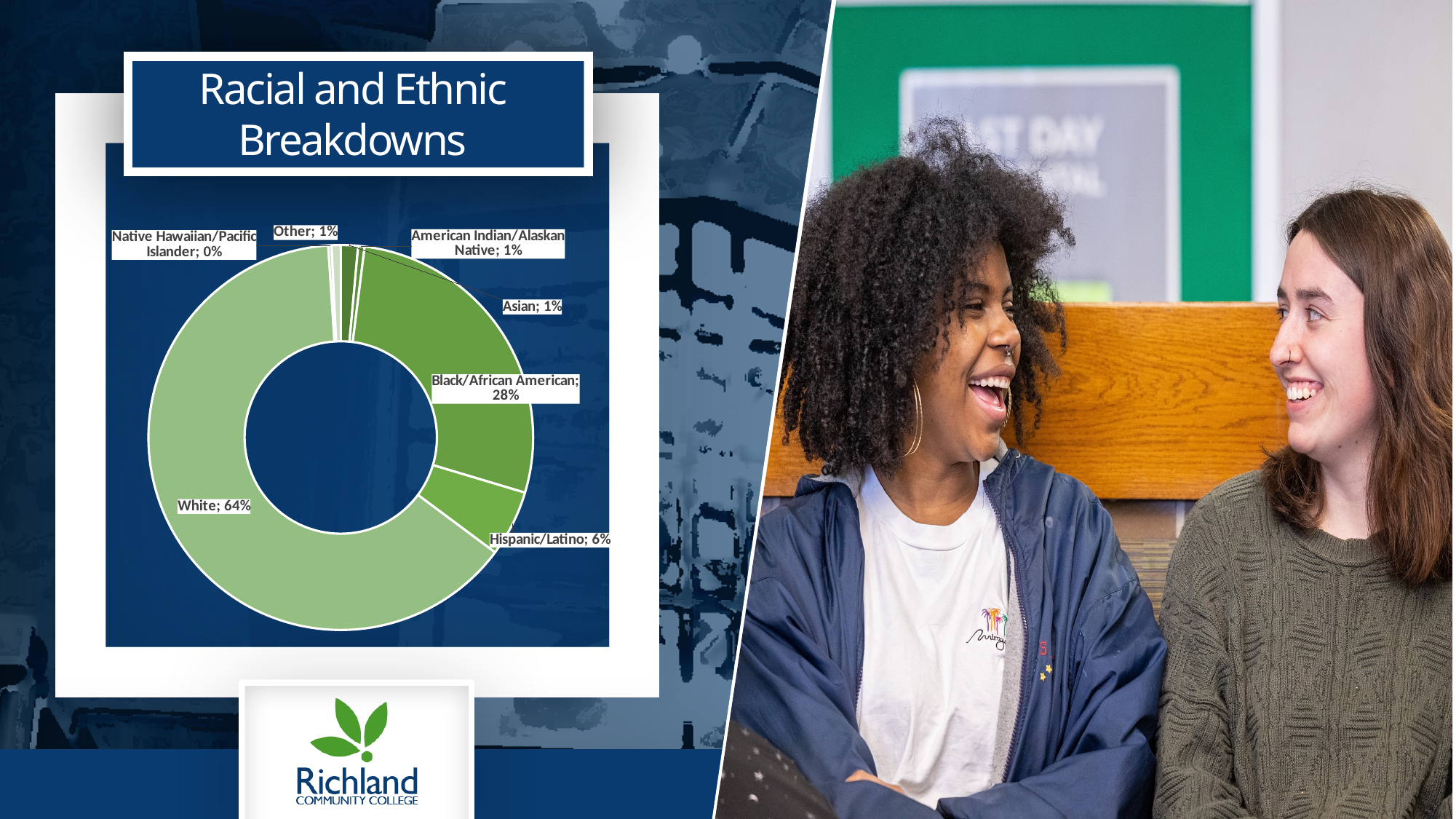
How many categories are shown in the chart? 7 What is the title of the chart? Racial and Ethnic Breakdowns What is the value for Black/African American? 28% Which category has the largest share? White What is the value for Asian? 1% What is the value for Native Hawaiian/Pacific Islander? 0% What kind of chart is shown on the slide? Pie chart (doughnut) What is the value for Hispanic/Latino? 6% Which is larger, Black/African American or Hispanic/Latino? Black/African American What is the difference between the White and Black/African American shares? 36% What share of the pie does White represent? 64% Which category has the smallest share? Native Hawaiian/Pacific Islander